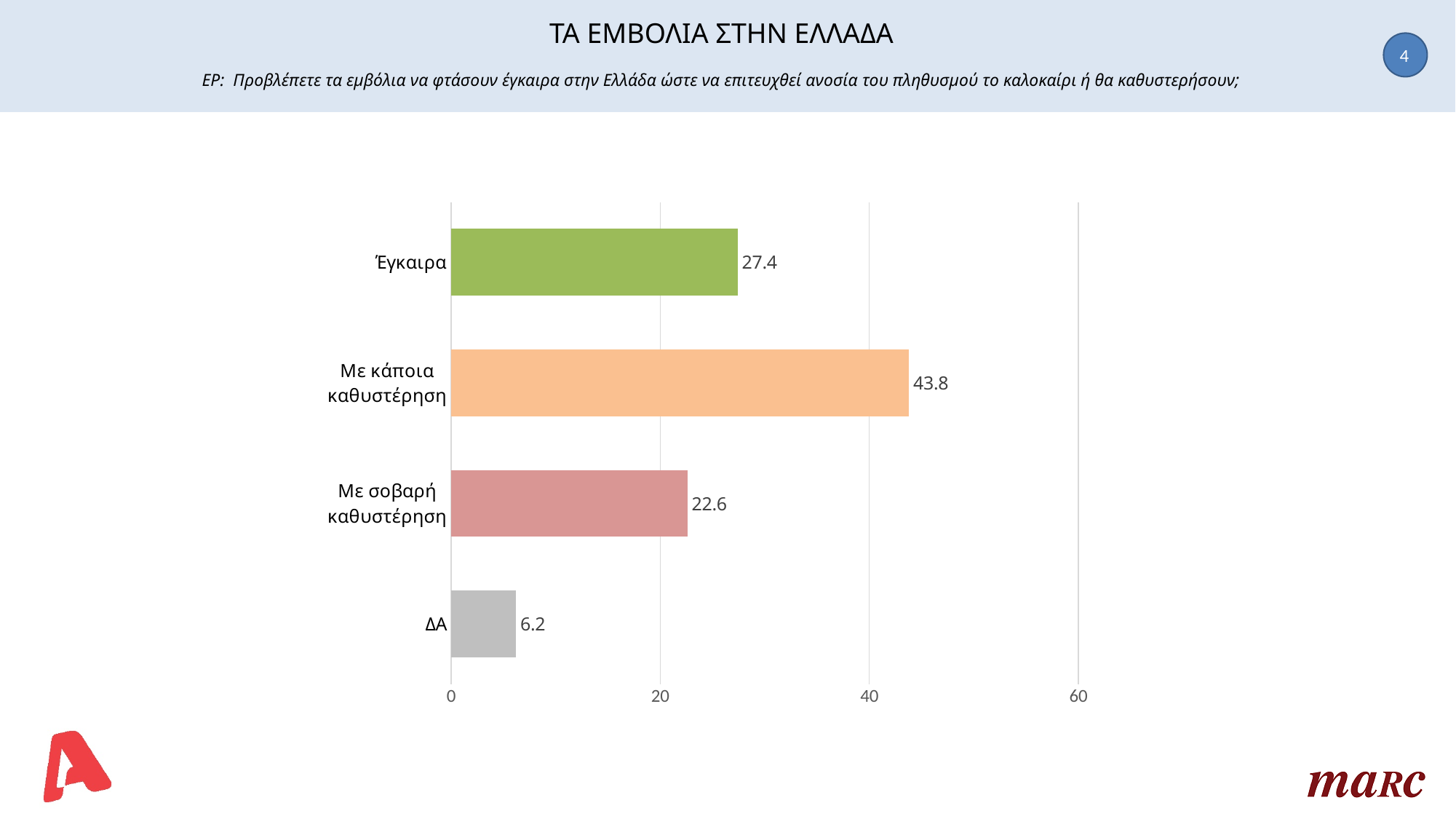
What is the value for Έγκαιρα? 27.4 Which is larger, the value for Έγκαιρα or the value for Με σοβαρή καθυστέρηση? Έγκαιρα What is the value for Με σοβαρή καθυστέρηση? 22.6 Which category has the lowest value? ΔΑ What is the value for Με κάποια καθυστέρηση? 43.8 What is the difference between the values for Με κάποια καθυστέρηση and Έγκαιρα? 16.4 What is the value for ΔΑ? 6.2 How many categories are shown in the chart? 4 Which category has the highest value? Με κάποια καθυστέρηση Is the value for Με κάποια καθυστέρηση greater or less than 40? greater What kind of chart is shown on the slide? bar chart What is the difference between the values for Έγκαιρα and Με σοβαρή καθυστέρηση? 4.8